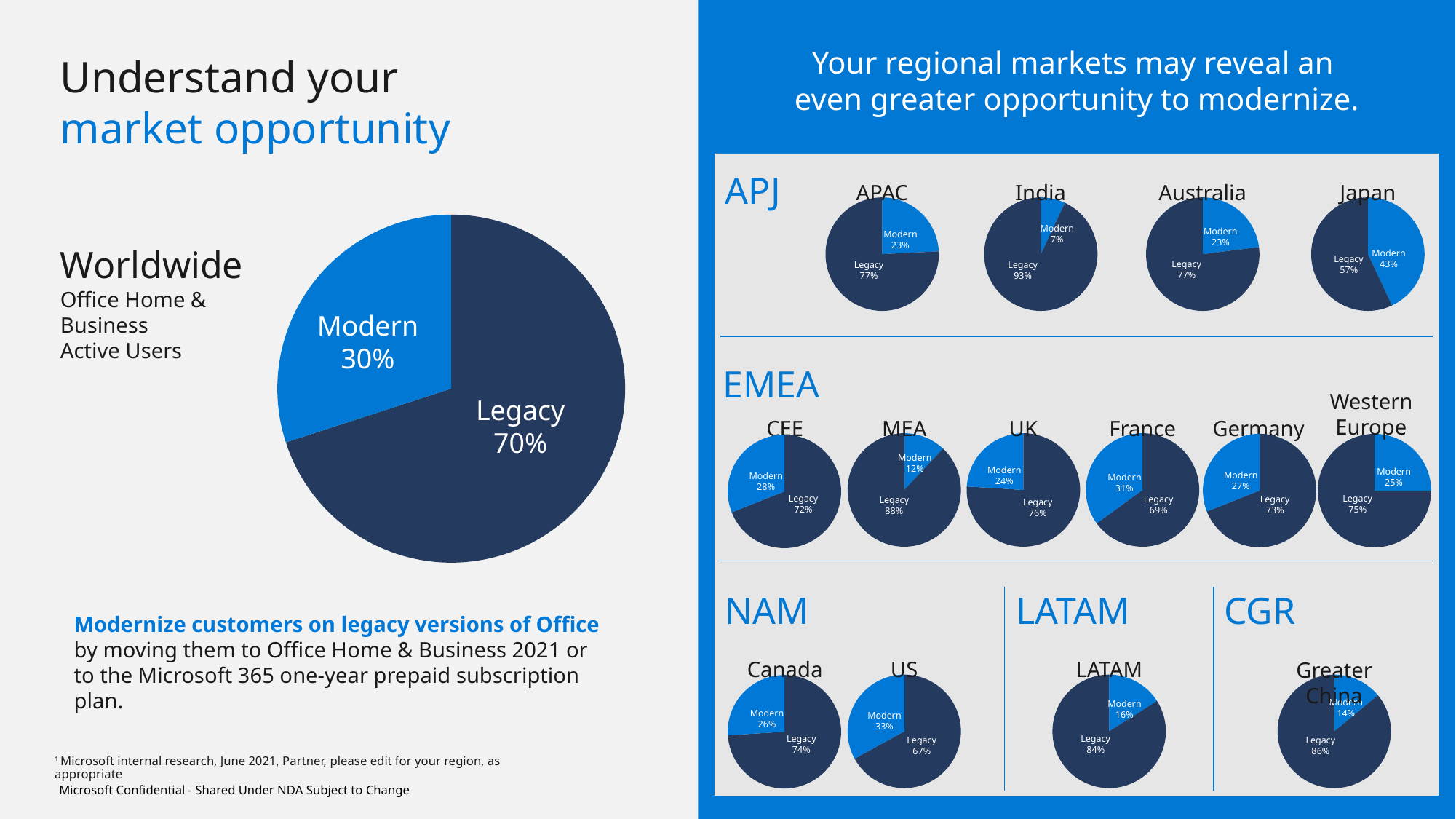
In the Japan pie chart, what is the Legacy share? 57% In the Greater China pie chart, what is the Legacy share? 86% Among the APJ pie charts (APAC, India, Australia, Japan), which market has the highest Modern share? Japan In the Worldwide pie chart, what share of Office Home & Business active users is Modern? 30% In the Worldwide pie chart, what share is Legacy? 70% Among the EMEA pie charts, which market has the lowest Modern share? MEA How many pie charts are shown in the EMEA section? 6 In the India pie chart, what is the Modern share? 7% In the LATAM pie chart, what is the Modern share? 16% What kind of chart is the Worldwide chart on the left of the slide? Pie chart Which has a larger Modern share, the US pie chart or the Canada pie chart? US In the France pie chart, what is the difference between the Legacy and Modern shares? 38%